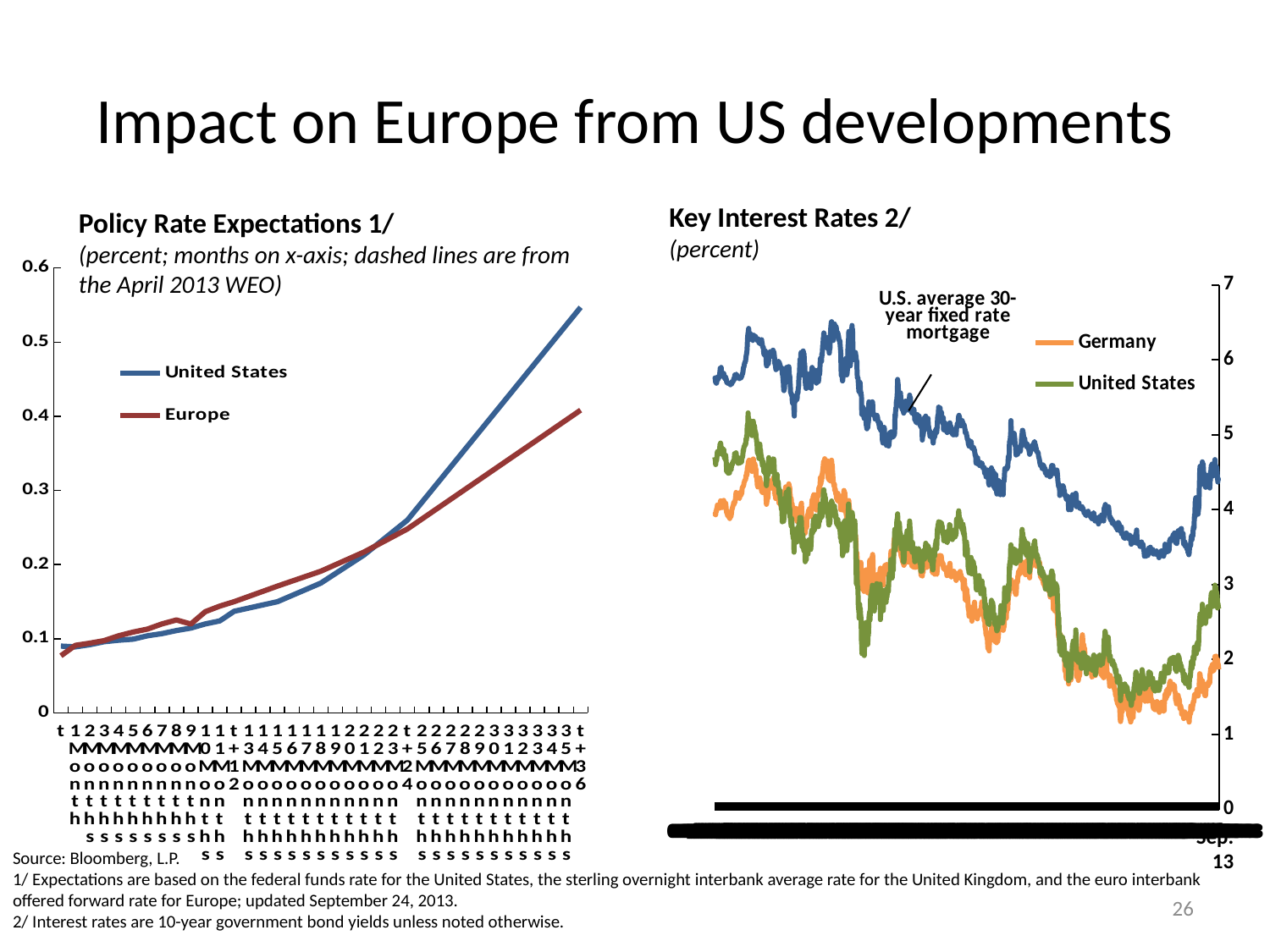
How many series does the legend of the Key Interest Rates chart list? 2 In the Policy Rate Expectations chart, is the final value for Europe greater or less than 0.5? less In the Key Interest Rates chart, is the final value of the U.S. average 30-year fixed rate mortgage greater or less than 5? less In the Key Interest Rates chart, which series is higher at the right end of the x axis, Germany or United States? United States What kind of chart is the Key Interest Rates chart on the right? line chart In the Key Interest Rates chart, is the lowest value for Germany greater or less than 2? less In the Policy Rate Expectations chart, do the United States values rise or fall along the x axis? rise In the Key Interest Rates chart, what colour is the Germany line? orange What kind of chart is the Policy Rate Expectations chart on the left? line chart In the Policy Rate Expectations chart, which series ends higher at the right end of the x axis, United States or Europe? United States How many series does the legend of the Policy Rate Expectations chart list? 2